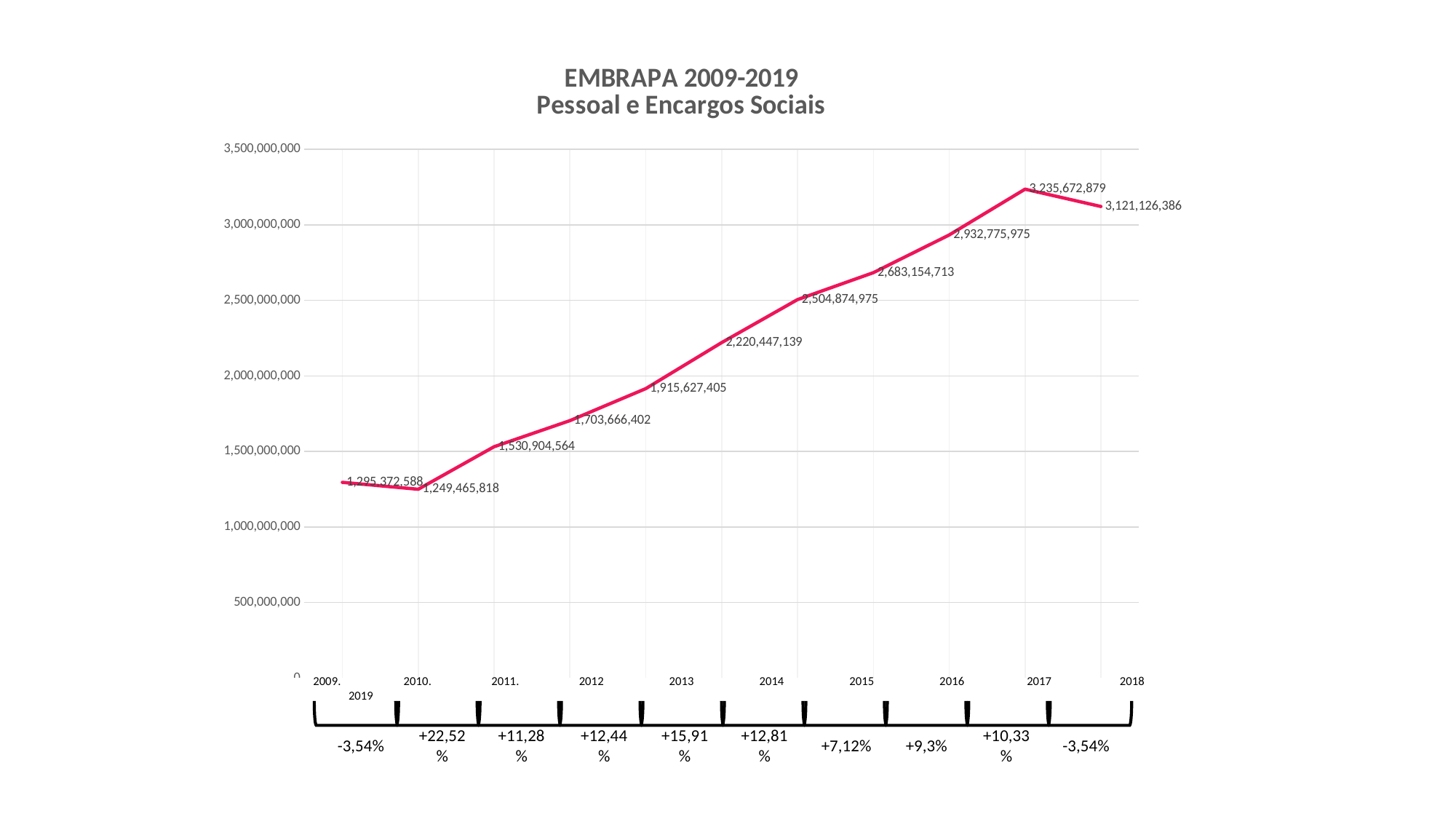
What percentage change is shown below the chart for the last interval (2018 to 2019)? -3,54% What is the value of the last data point on the line (2019)? 3,121,126,386 What is the highest value plotted on the line? 3,235,672,879 How many data points are plotted on the line? 11 What is the title of the chart? EMBRAPA 2009-2019 Pessoal e Encargos Sociais What kind of chart is shown on the slide? line chart Which is larger, the value of the first data point (1,295,372,588) or the second data point (1,249,465,818)? 1,295,372,588 Is the value of the last data point greater or less than 3,000,000,000? greater What is the lowest value plotted on the line? 1,249,465,818 What is the value of the first data point on the line (2009)? 1,295,372,588 Does the line generally rise or fall from 2010 to 2018? rise